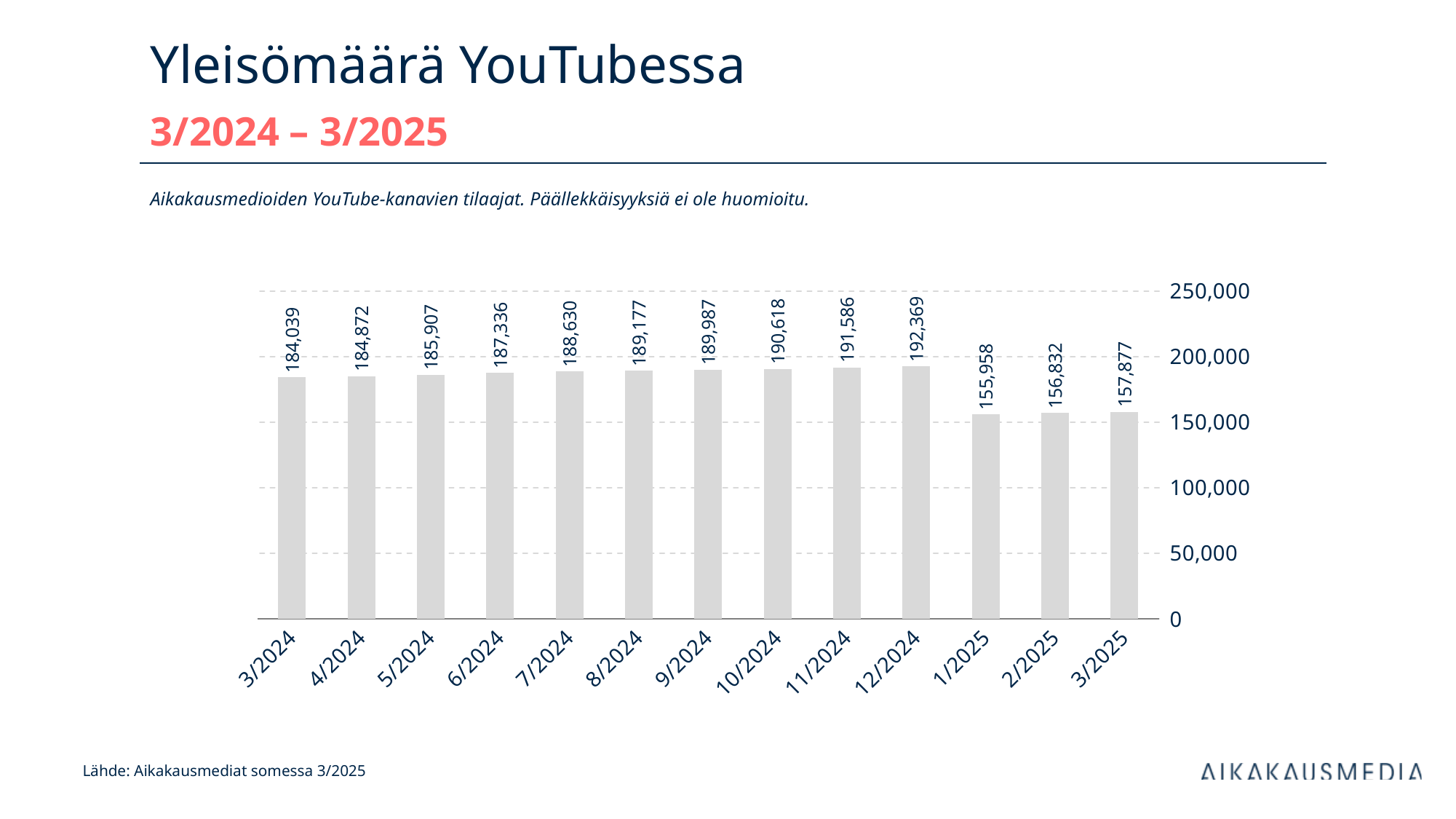
What is the value for 3/2025? 157,877 What is the value for 3/2024? 184,039 How many months are shown on the x axis? 13 What is the title of the chart on the slide? Yleisömäärä YouTubessa What is the difference between the values for 12/2024 and 1/2025? 36,411 What is the value for 1/2025? 155,958 Which month has the highest value? 12/2024 Is the value for 11/2024 greater or less than 200,000? less Which is larger, the value for 9/2024 or the value for 2/2025? 9/2024 What kind of chart is shown on the slide? bar chart What is the value for 12/2024? 192,369 Which month has the lowest value? 1/2025